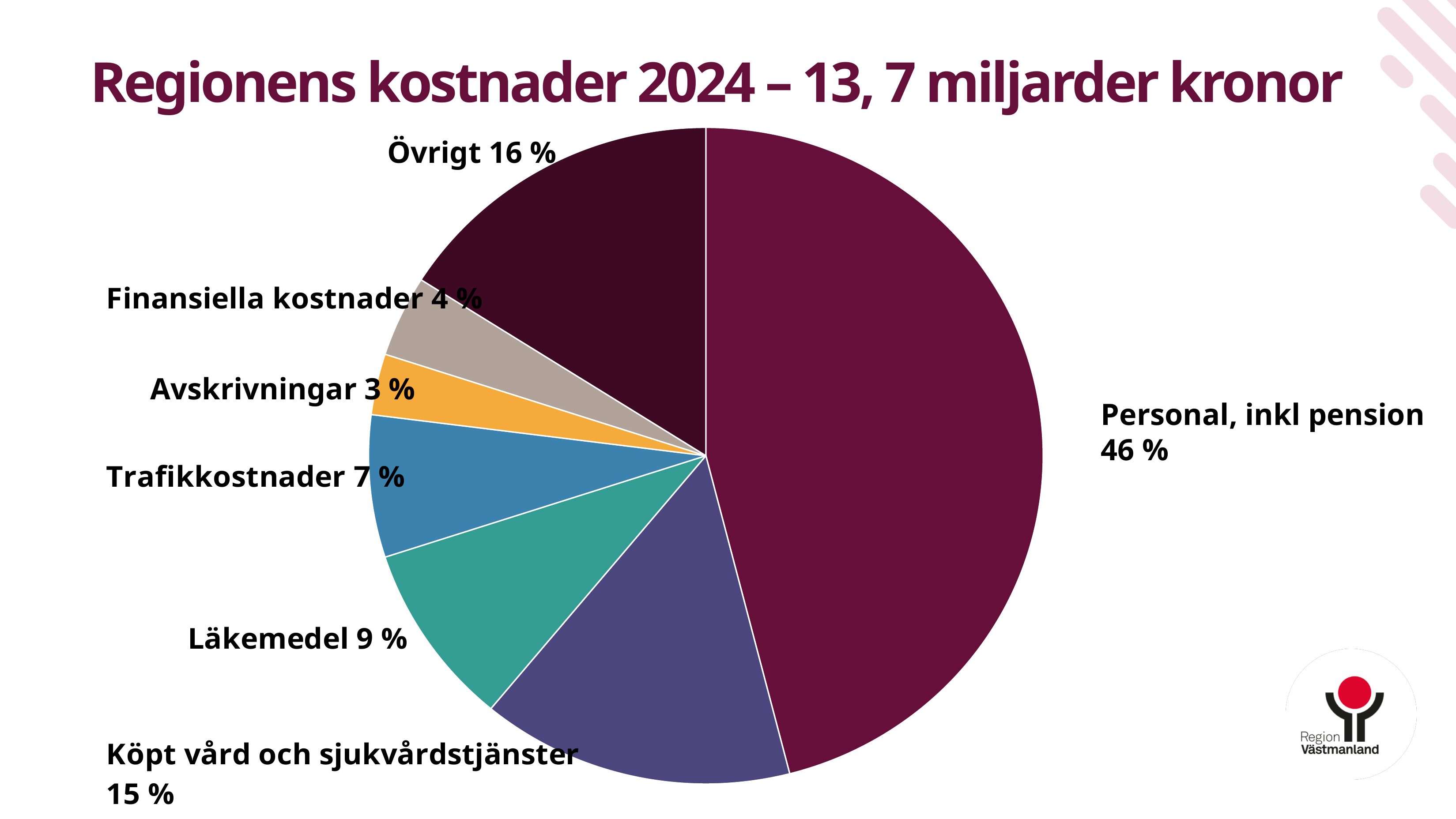
How many categories are shown in the pie chart? 7 Which category has the largest slice of the pie? Personal, inkl pension What is the value shown for Läkemedel? 9 % What kind of chart is shown on the slide? Pie chart What is the value shown for Köpt vård och sjukvårdstjänster? 15 % What share of the pie does Personal, inkl pension represent? 46 % Which category has the smallest slice of the pie? Avskrivningar What is the value shown for Trafikkostnader? 7 % What is the difference between the shares of Övrigt and Finansiella kostnader? 12 % Which is larger, the share for Läkemedel or the share for Trafikkostnader? Läkemedel What is the title of the chart on the slide? Regionens kostnader 2024 – 13, 7 miljarder kronor What is the value shown for Avskrivningar? 3 %